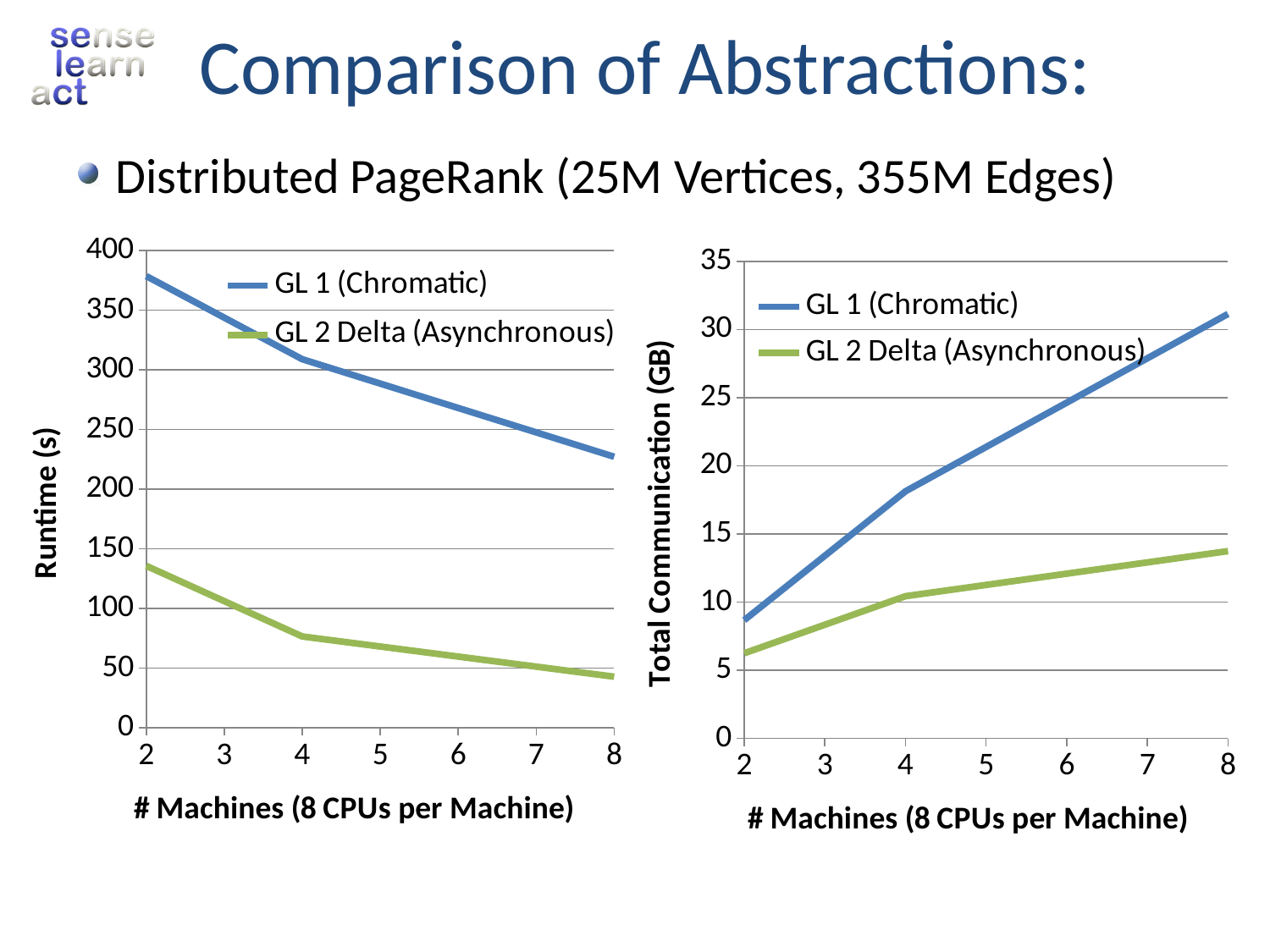
In the right chart (Total Communication (GB)), which series has the lower total communication at 6 machines, GL 1 (Chromatic) or GL 2 Delta (Asynchronous)? GL 2 Delta (Asynchronous) In the left chart (Runtime (s)), does the runtime for GL 1 (Chromatic) rise or fall as the number of machines increases? fall In the right chart (Total Communication (GB)), is the value for GL 2 Delta (Asynchronous) at 8 machines greater or less than 15? less In the right chart (Total Communication (GB)), does the total communication for GL 1 (Chromatic) rise or fall as the number of machines increases? rise In the left chart (Runtime (s)), is the runtime for GL 1 (Chromatic) at 2 machines greater or less than 350? greater In the left chart (Runtime (s)), is the runtime for GL 1 (Chromatic) at 8 machines greater or less than 250? less In the left chart (Runtime (s)), which series has the higher runtime at 4 machines, GL 1 (Chromatic) or GL 2 Delta (Asynchronous)? GL 1 (Chromatic) How many series does the legend of the right chart (Total Communication (GB)) list? 2 What kind of chart is the left chart (Runtime (s))? line chart What is the x-axis title of the left chart (Runtime (s))? # Machines (8 CPUs per Machine)